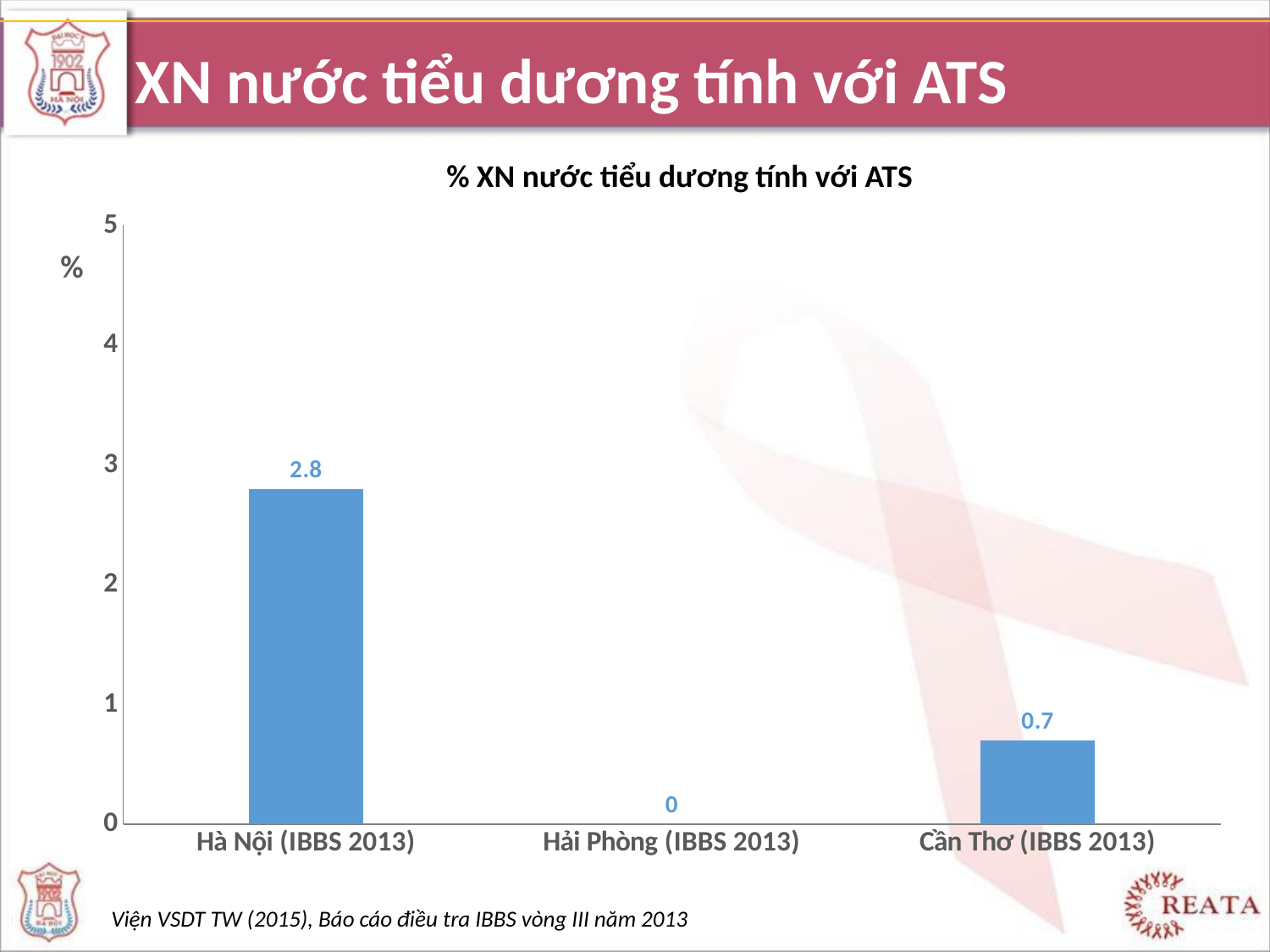
Which category has the highest value? Hà Nội (IBBS 2013) Is the value for Hà Nội (IBBS 2013) greater or less than 3? less Which is larger, the value for Hà Nội (IBBS 2013) or the value for Cần Thơ (IBBS 2013)? Hà Nội (IBBS 2013) What is the difference between the values for Hà Nội (IBBS 2013) and Cần Thơ (IBBS 2013)? 2.1 What is the title of the chart? % XN nước tiểu dương tính với ATS What is the maximum value shown on the y axis? 5 What is the value for Hà Nội (IBBS 2013)? 2.8 What is the value for Hải Phòng (IBBS 2013)? 0 What kind of chart is shown on the slide? bar chart Which category has the lowest value? Hải Phòng (IBBS 2013) What is the value for Cần Thơ (IBBS 2013)? 0.7 How many categories are shown on the x axis? 3